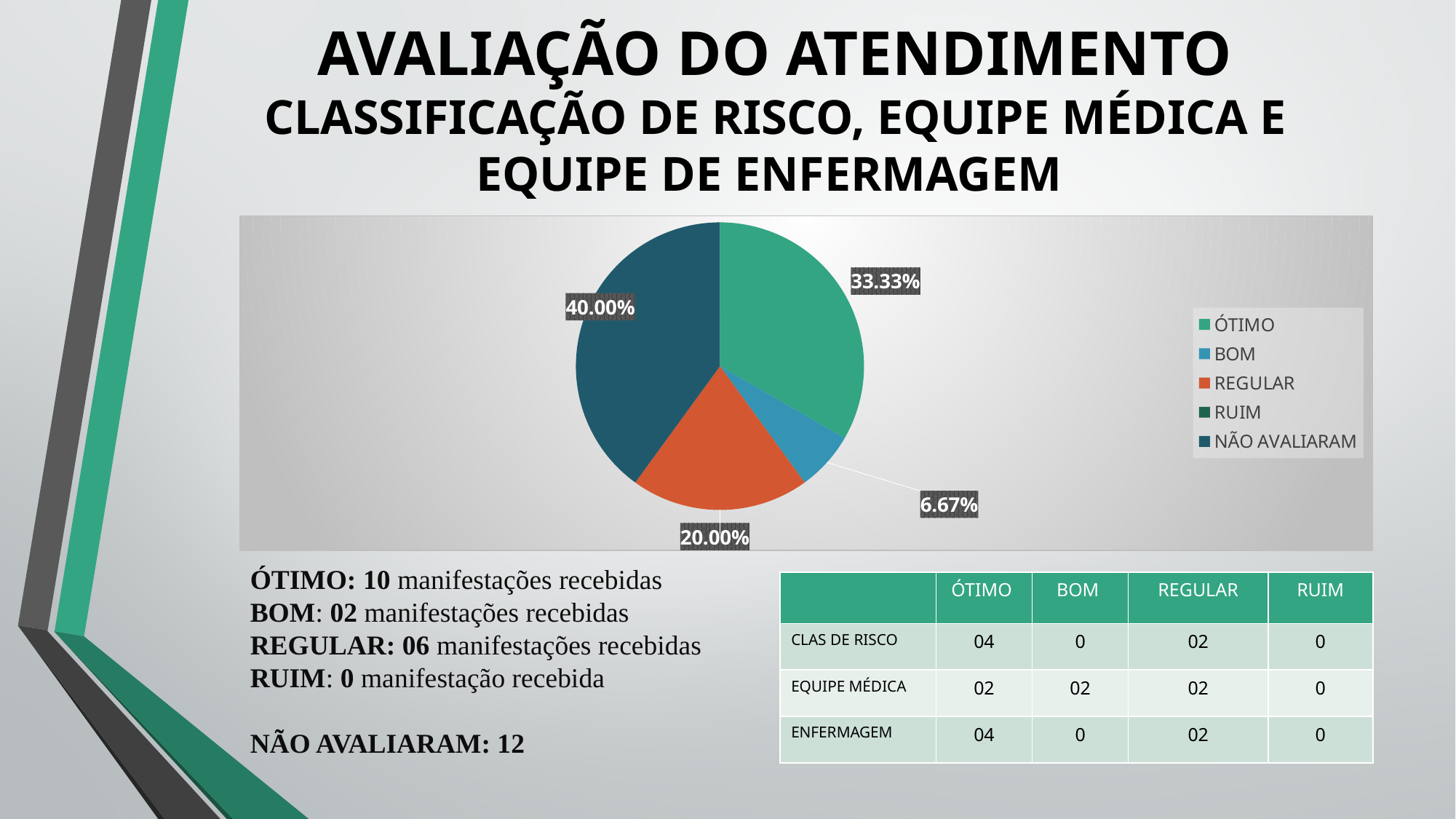
What percentage of the pie chart does the ÓTIMO slice represent? 33.33% How many entries does the pie chart's legend list? 5 Which category has the smallest printed percentage in the pie chart? BOM What percentage is shown for the NÃO AVALIARAM slice in the pie chart? 40.00% What percentage is labelled on the BOM slice of the pie chart? 6.67% Which category has the largest slice in the pie chart? NÃO AVALIARAM Which slice is larger in the pie chart, ÓTIMO or REGULAR? ÓTIMO What type of chart is shown on the slide? Pie chart What is the difference in percentage points between the REGULAR slice and the BOM slice? 13.33 percentage points What percentage is labelled on the REGULAR slice of the pie chart? 20.00% By how many percentage points does the NÃO AVALIARAM slice exceed the ÓTIMO slice? 6.67 percentage points Which legend entry of the pie chart has no visible slice? RUIM